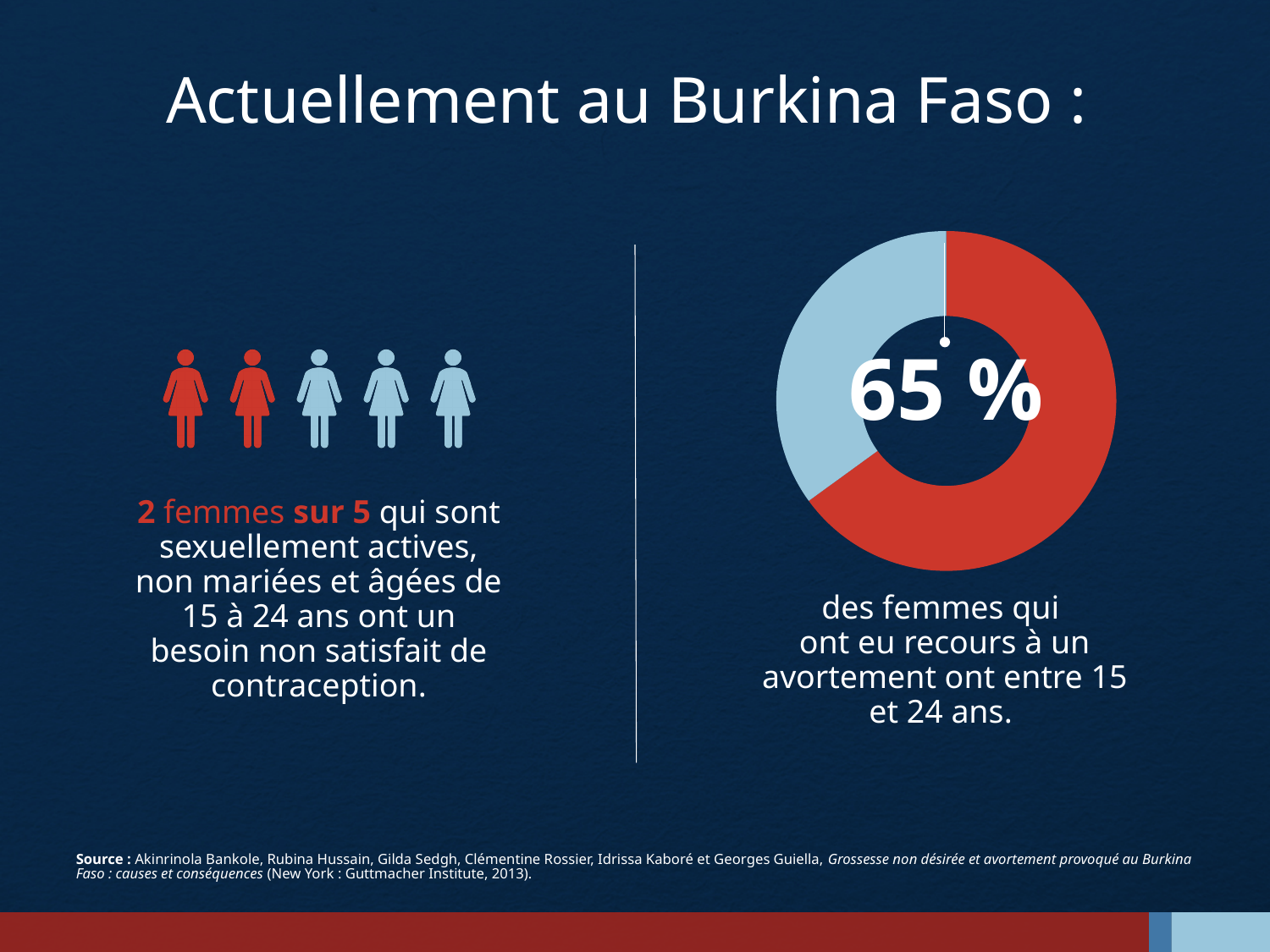
What kind of chart is shown on the right side of the slide? Donut (pie) chart What colour is the 65 % slice of the donut chart? Red In the donut chart, which slice is larger, the red one or the light blue one? The red one How many slices does the donut chart have? 2 In the pictogram on the left, how many of the woman figures are red? 2 What percentage does the light blue slice of the donut chart represent? 35 % According to the pictogram on the left, how many women out of 5 have an unmet need for contraception? 2 sur 5 In the donut chart, what share of women who had an abortion are aged 15 to 24? 65 % What percentage is printed in the centre of the donut chart? 65 % In the pictogram on the left, how many of the woman figures are light blue? 3 Is the value shown in the donut chart greater or less than 50 %? greater How many woman figures are shown in the pictogram on the left of the slide? 5